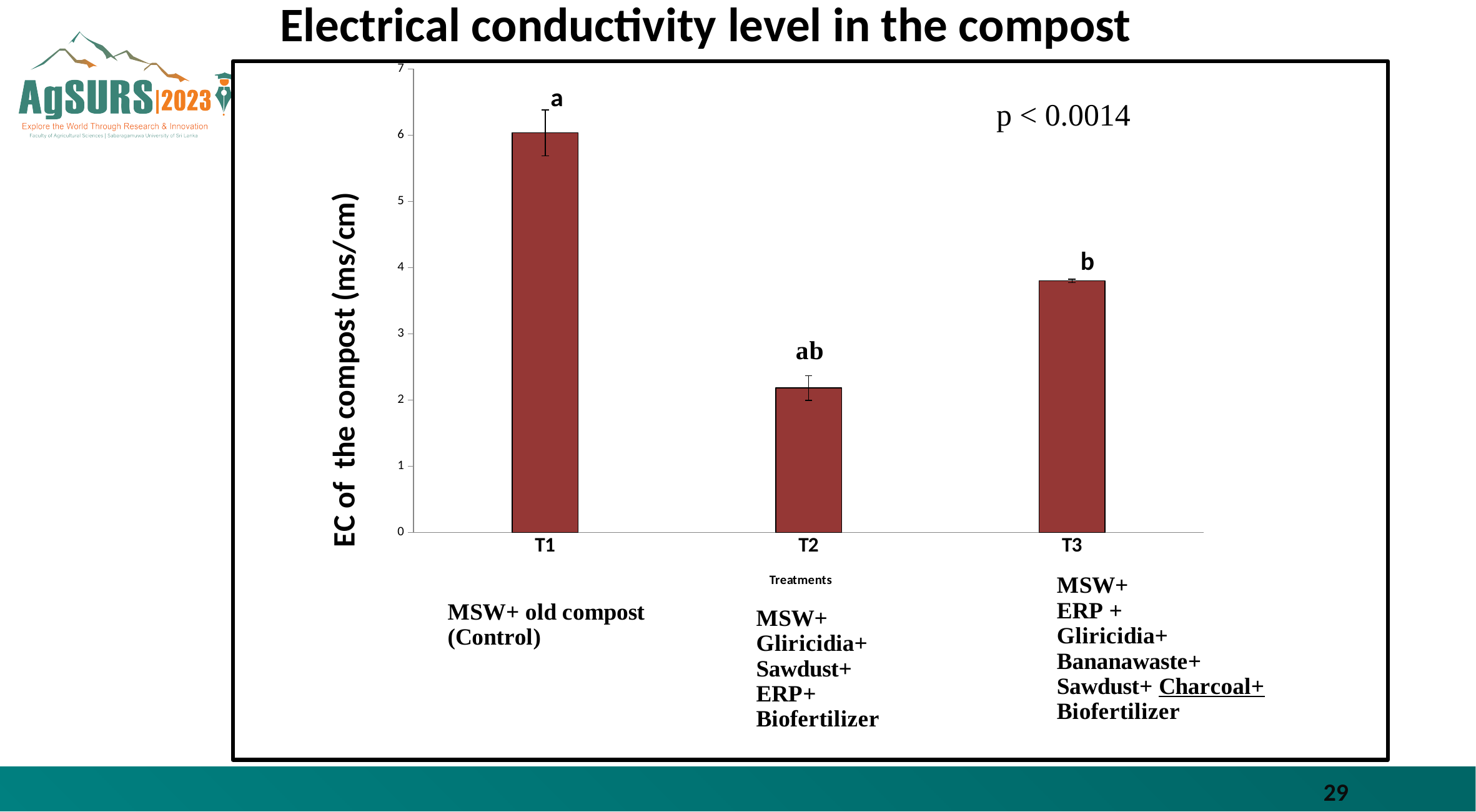
Which treatment has the lowest EC of the compost? T2 What is the highest value shown on the y axis? 7 What is the label on the y axis of the chart? EC of the compost (ms/cm) What significance letter is printed above the T3 bar? b Which has a higher EC value, T2 or T3? T3 How many treatments are plotted on the x axis? 3 Is the EC value for T2 greater or less than 3? less What kind of chart is shown on the slide? bar chart Is the EC value for T1 greater or less than 5? greater Which treatment has the highest EC of the compost? T1 Is the EC value for T3 greater or less than 3? greater Which has a higher EC value, T1 or T3? T1